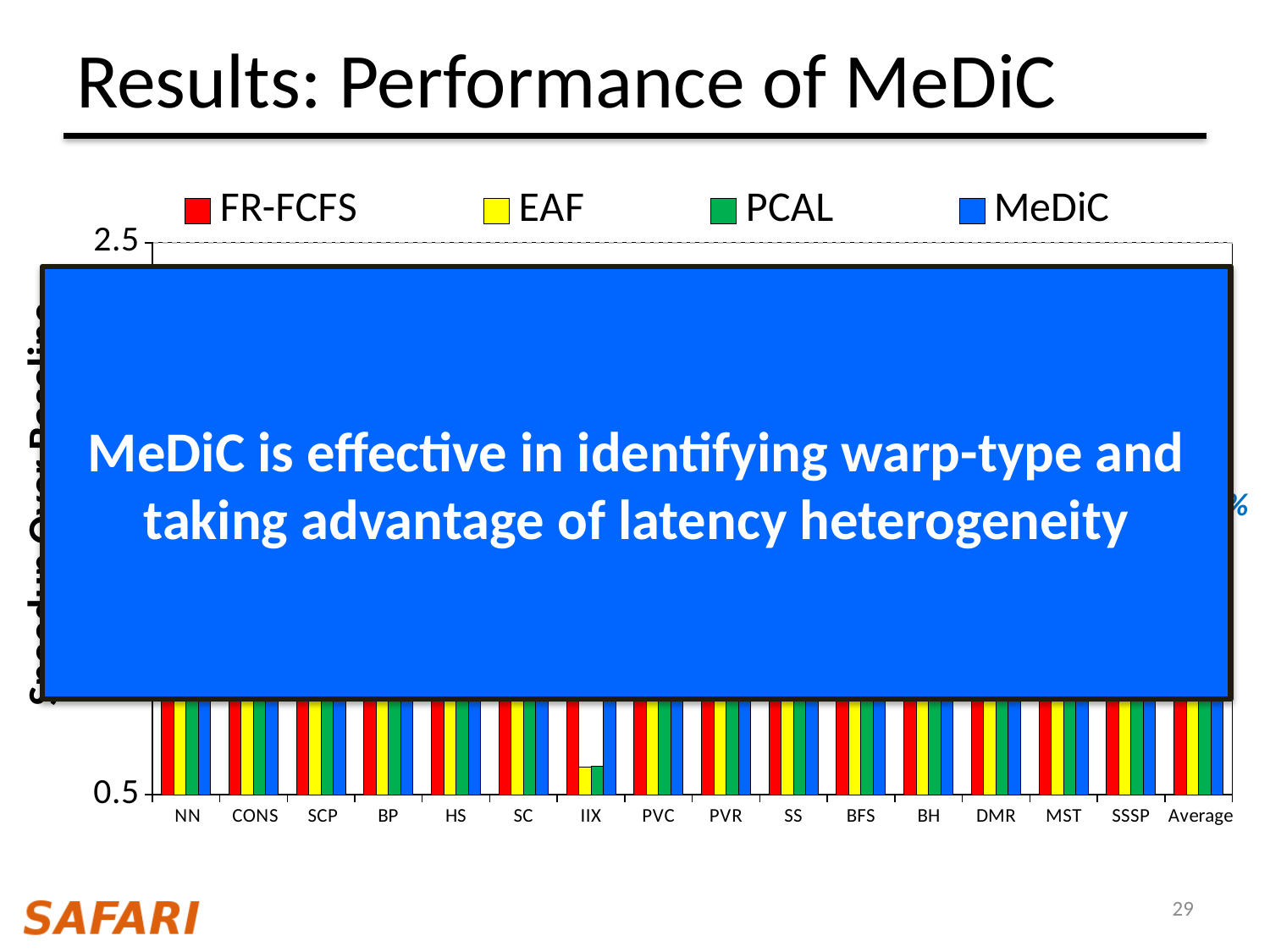
Is the EAF value for IIX greater or less than 0.5? greater What is the highest value shown on the y axis of the chart? 2.5 How many categories are shown along the x axis of the chart? 16 What kind of chart is shown on the slide? bar chart What is the label of the last category on the x axis? Average Which series is shown in blue in the chart's legend? MeDiC How many series does the chart's legend list? 4 Is the PCAL value for IIX greater or less than 0.5? greater Which series is shown in red in the chart's legend? FR-FCFS